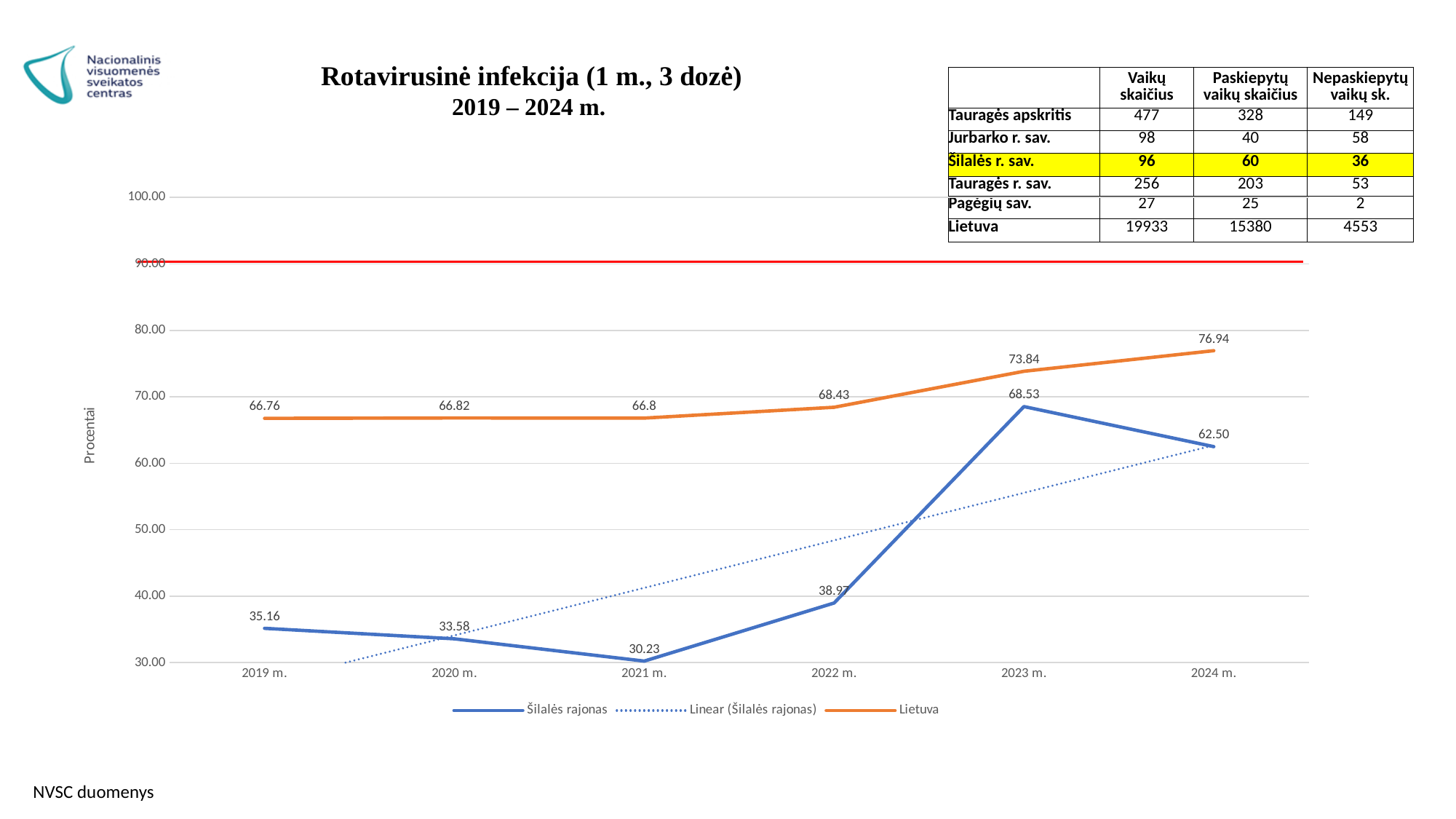
What kind of chart is shown on the slide? line chart Does the Lietuva series rise or fall from 2022 m. to 2024 m.? rise What is the value for Šilalės rajonas in 2021 m.? 30.23 In which year is the Šilalės rajonas value lowest? 2021 m. How many entries does the legend list? 3 What is the value for Lietuva in 2024 m.? 76.94 In which year is the Lietuva value highest? 2024 m. Which is larger in 2024 m., the Šilalės rajonas value or the Lietuva value? Lietuva Is the value for Šilalės rajonas in 2022 m. greater or less than 40.00? less What is the value for Šilalės rajonas in 2023 m.? 68.53 What is the difference between the Lietuva and Šilalės rajonas values in 2019 m.? 31.60 How many years are shown on the x axis? 6